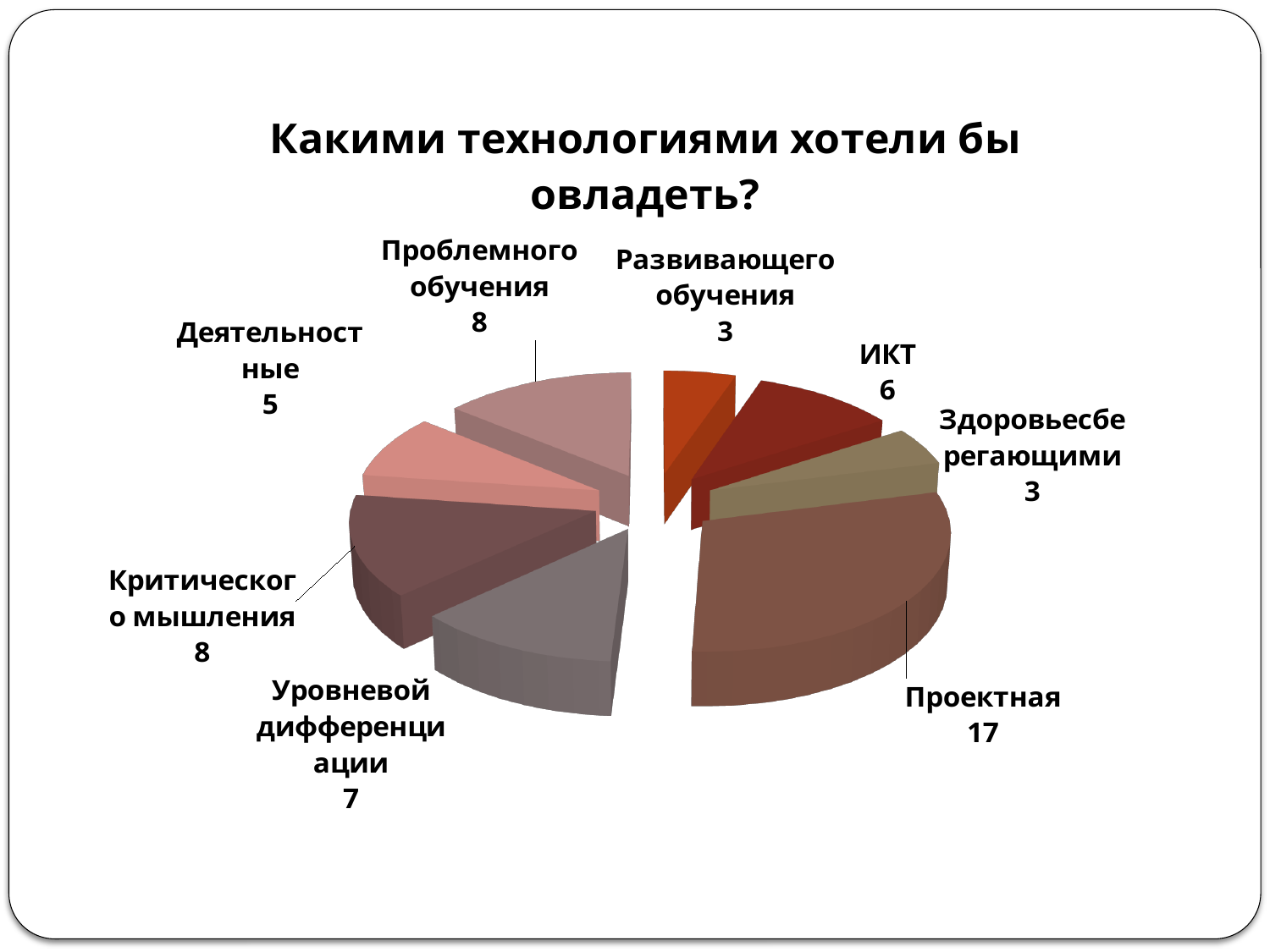
What kind of chart is shown on the slide? pie chart What is the value for ИКТ? 6 Which category has the highest value? Проектная What is the title of the chart? Какими технологиями хотели бы овладеть? What is the value for Проектная? 17 What is the value for Уровневой дифференциации? 7 How many categories (slices) does the pie chart have? 8 Which is larger, the value for ИКТ or the value for Деятельностные? ИКТ Which two categories both have a value of 3? Развивающего обучения and Здоровьесберегающими What is the value for Деятельностные? 5 What is the difference between the values for Проблемного обучения and Развивающего обучения? 5 What is the difference between the values for Проектная and Критического мышления? 9